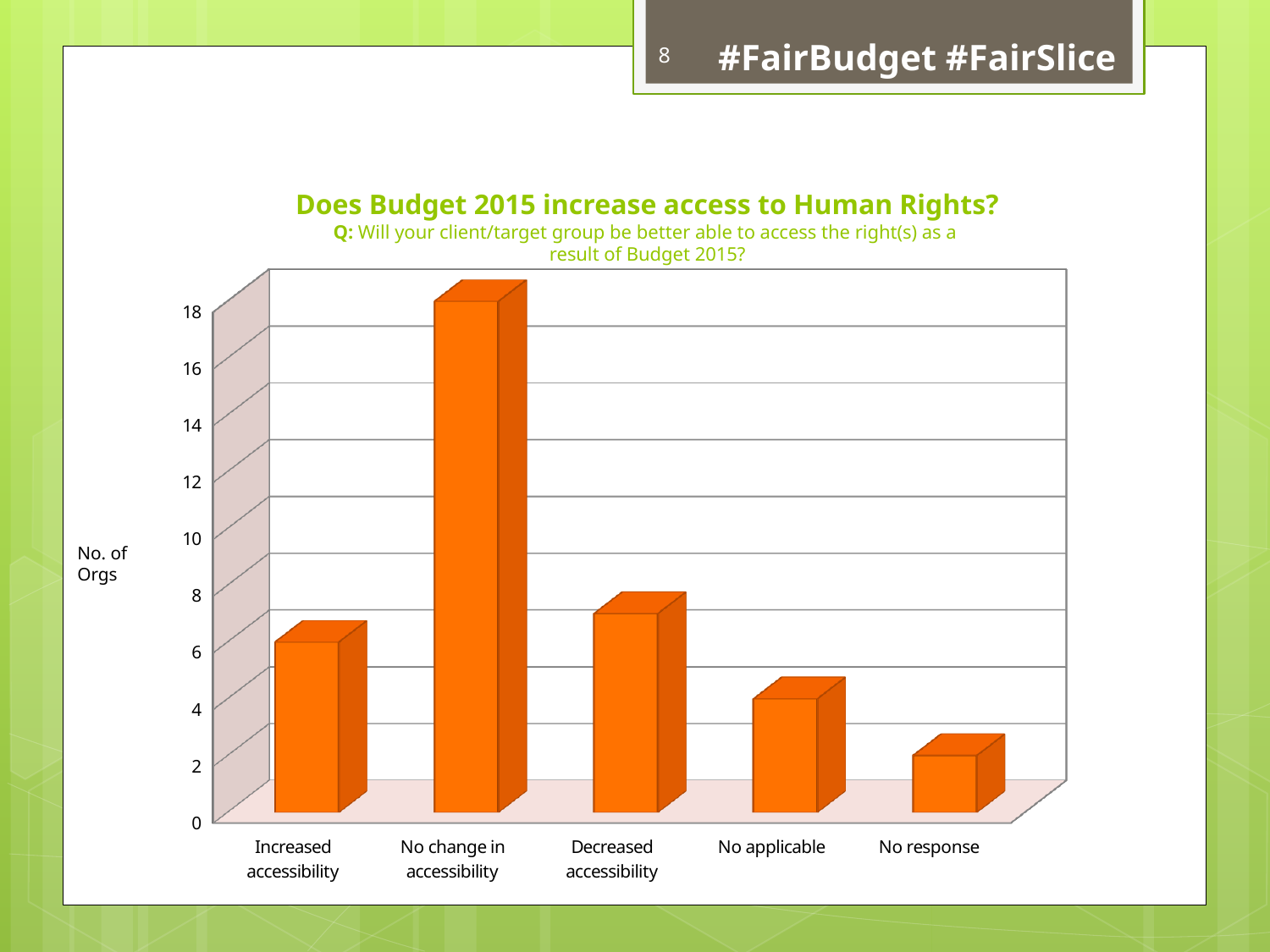
Which is larger, the value for No change in accessibility or the value for Decreased accessibility? No change in accessibility Which is larger, the value for Increased accessibility or the value for No applicable? Increased accessibility Is the value for Decreased accessibility greater or less than 4? greater How many categories are shown on the x axis of the chart? 5 What is the label on the vertical axis of the chart? No. of Orgs Is the value for No response greater or less than 4? less Which category has the highest number of organisations? No change in accessibility What kind of chart is shown on the slide? bar chart Is the value for No applicable greater or less than 6? less Which category has the lowest number of organisations? No response